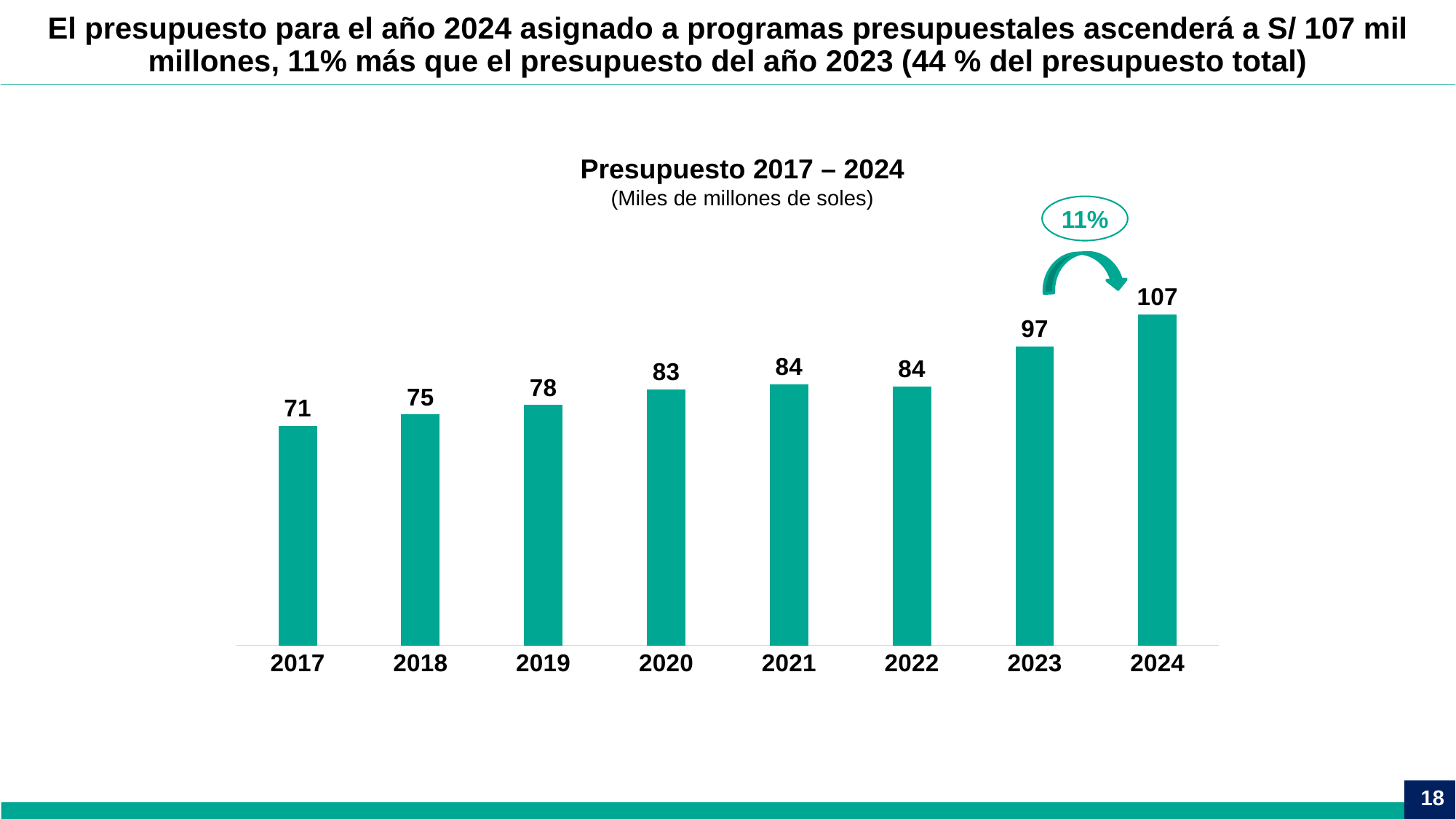
What is the difference between the budget values for 2024 and 2023? 10 What is the difference between the budget values for 2019 and 2017? 7 What is the budget value shown for 2023? 97 How many years are shown on the x axis of the chart? 8 Which year has the highest budget value? 2024 What kind of chart is shown on the slide? Bar chart What is the budget value shown for 2017? 71 What is the title of the chart? Presupuesto 2017 – 2024 Do the budget values generally rise or fall from 2017 to 2024? Rise Which year has the lowest budget value? 2017 What is the budget value shown for 2020? 83 Which is larger, the budget value for 2018 or for 2022? 2022